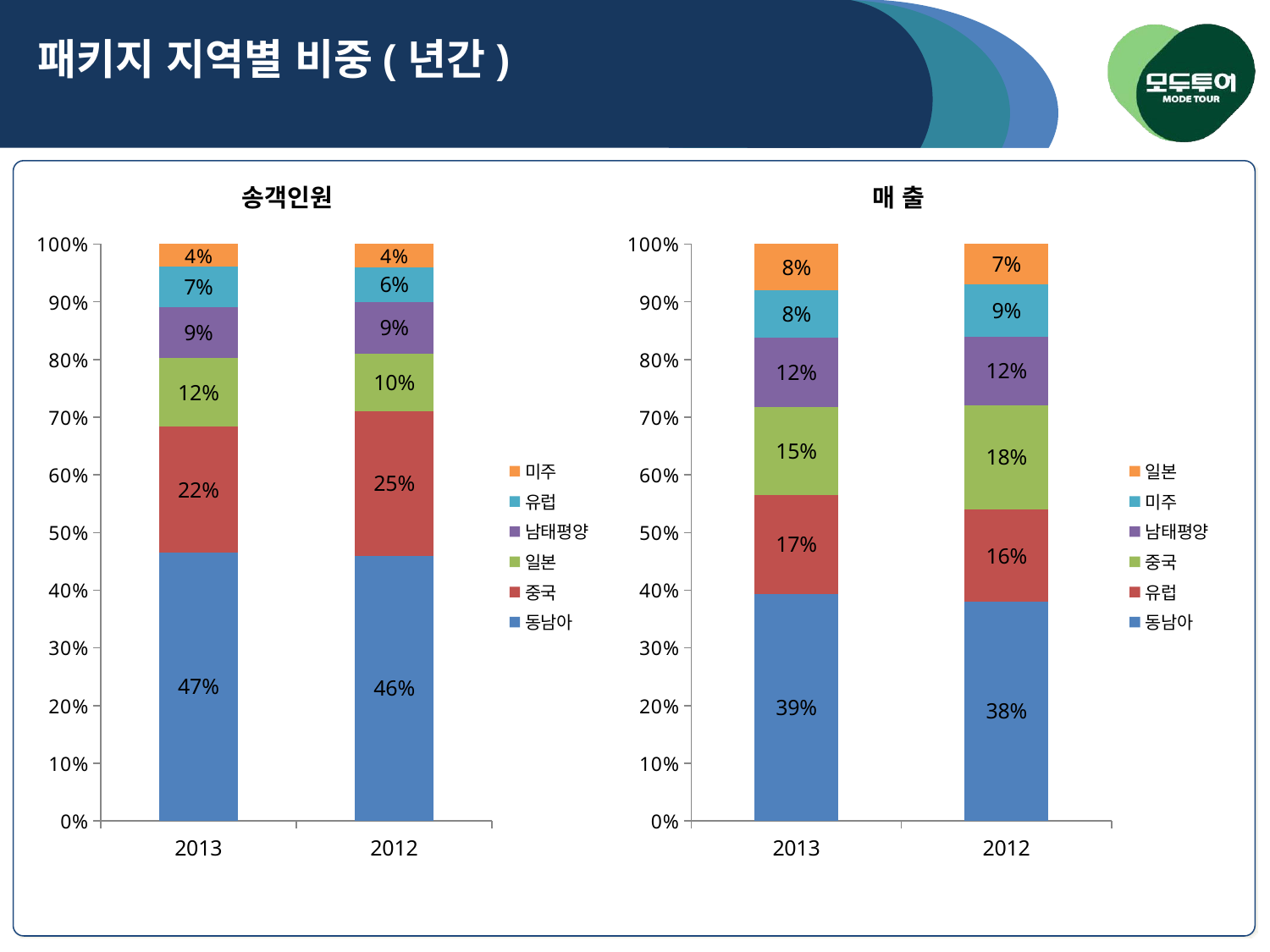
What kind of chart is the 매출 chart? Stacked bar chart How many years are shown on the x axis of the 송객인원 chart? 2 In the 매출 chart, which is larger in 2013: the 유럽 share or the 중국 share? 유럽 How many series does the legend of the 매출 chart list? 6 In the 매출 chart, what is the value for 유럽 in 2013? 17% In the 매출 chart, what is the difference between the 동남아 share in 2013 and in 2012? 1% In the 송객인원 chart, what is the value for 중국 in 2012? 25% In the 송객인원 chart, what is the difference between the 중국 share in 2012 and in 2013? 3% In the 송객인원 chart, what is the value for 동남아 in 2013? 47% In the 매출 chart, what is the value for 중국 in 2012? 18% In the 송객인원 chart, which region has the largest share in 2013? 동남아 In the 매출 chart, which region has the smallest share in 2012? 일본